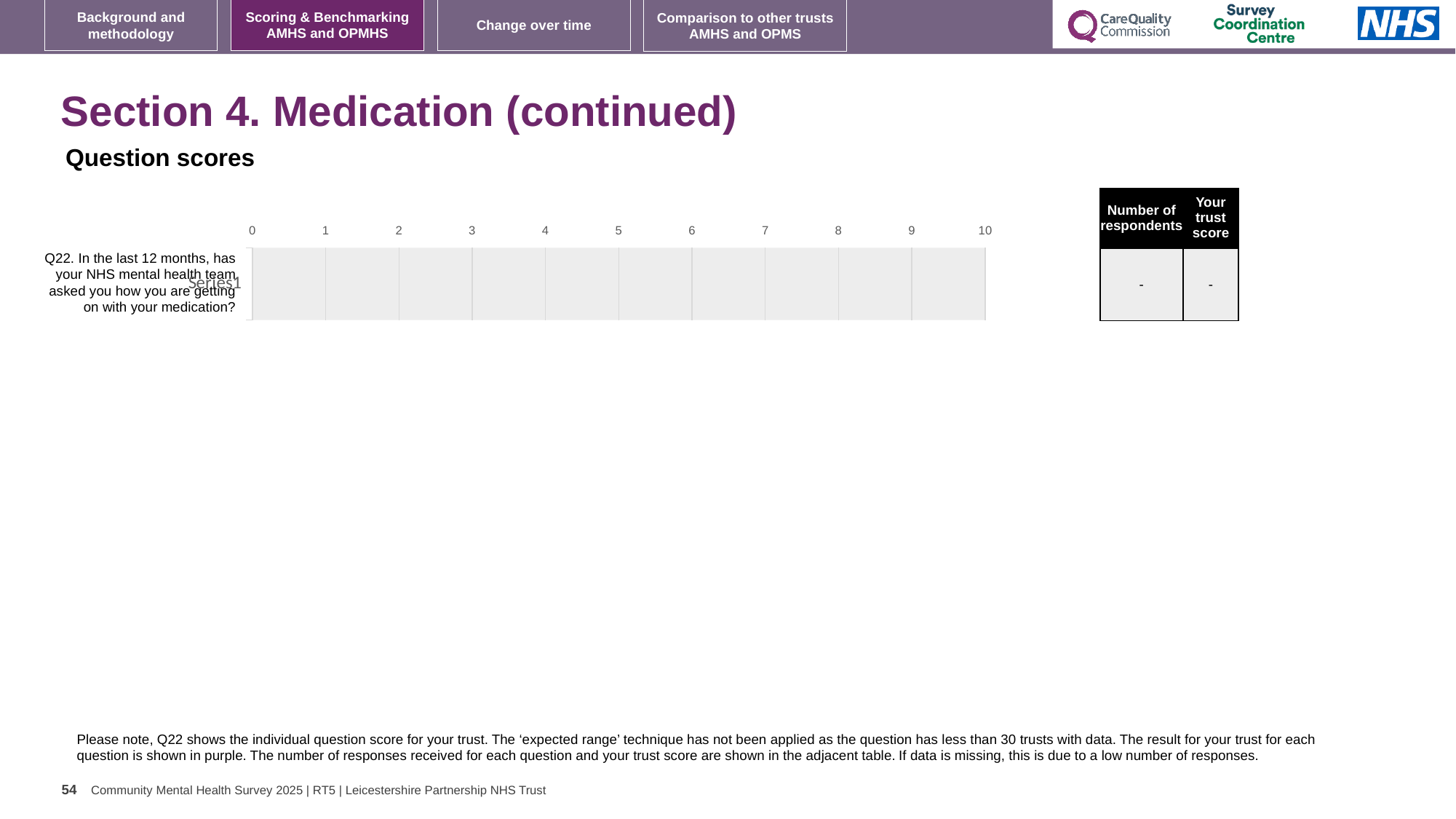
What is the number of respondents shown in the table for Q22? - What is the highest value shown on the chart's horizontal axis? 10 What is the trust score shown in the table for Q22? - What is the lowest value shown on the chart's horizontal axis? 0 What kind of chart is shown on the slide? bar chart How many question categories are listed on the chart's vertical axis? 1